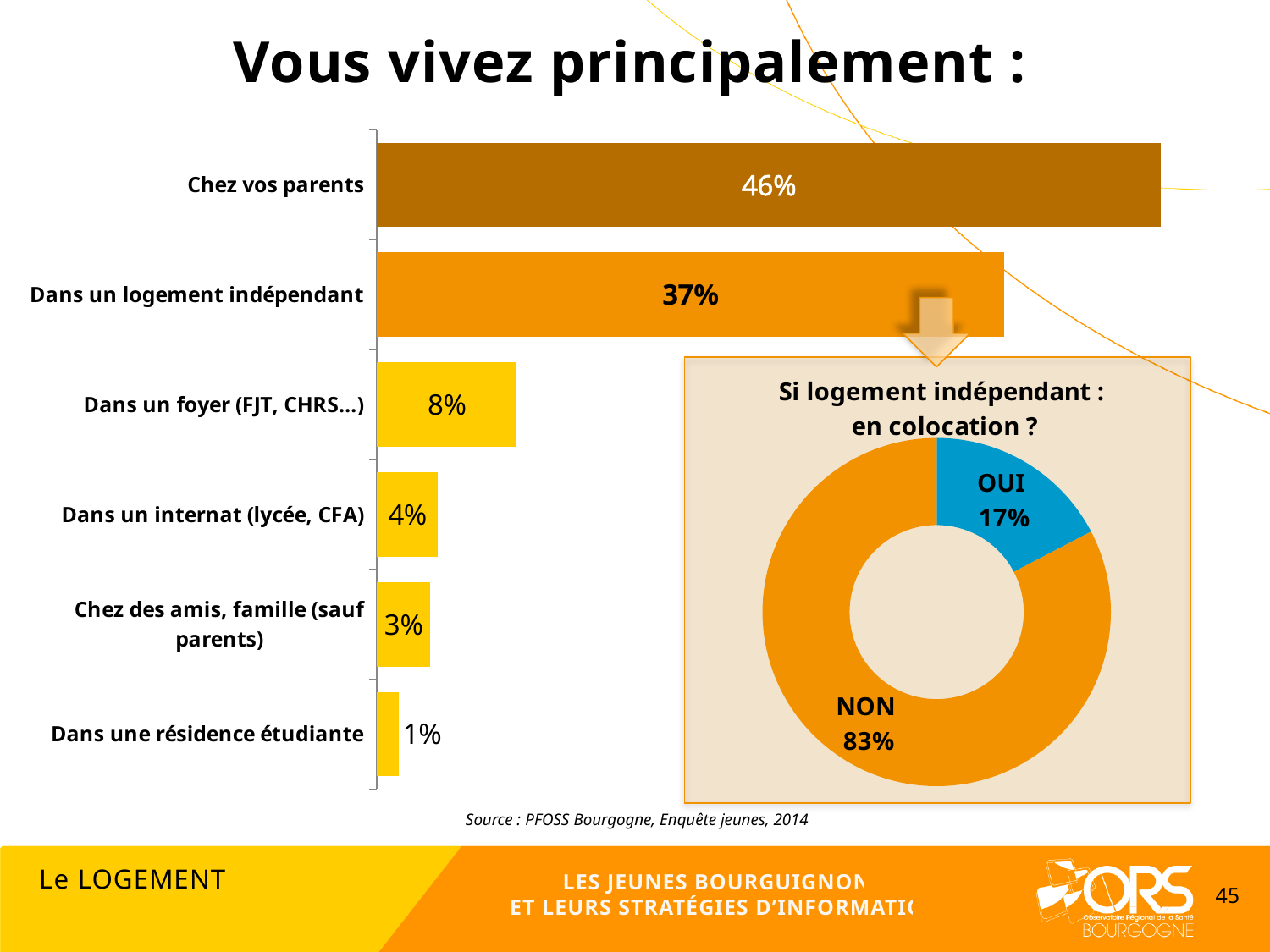
In the bar chart 'Vous vivez principalement :', which is larger: 'Dans un internat (lycée, CFA)' or 'Chez des amis, famille (sauf parents)'? Dans un internat (lycée, CFA) In the bar chart 'Vous vivez principalement :', what is the value for 'Chez vos parents'? 46% In the bar chart 'Vous vivez principalement :', what is the difference between 'Chez vos parents' and 'Dans un logement indépendant'? 9% In the doughnut chart 'Si logement indépendant : en colocation ?', what is the share for 'OUI'? 17% In the doughnut chart 'Si logement indépendant : en colocation ?', what is the share for 'NON'? 83% In the bar chart 'Vous vivez principalement :', which category has the highest value? Chez vos parents What is the source cited below the charts? PFOSS Bourgogne, Enquête jeunes, 2014 What kind of chart is 'Vous vivez principalement :'? Bar chart How many categories does the bar chart 'Vous vivez principalement :' show? 6 In the bar chart 'Vous vivez principalement :', which category has the lowest value? Dans une résidence étudiante In the bar chart 'Vous vivez principalement :', what is the value for 'Dans un logement indépendant'? 37% In the bar chart 'Vous vivez principalement :', what is the value for 'Dans un foyer (FJT, CHRS...)'? 8%